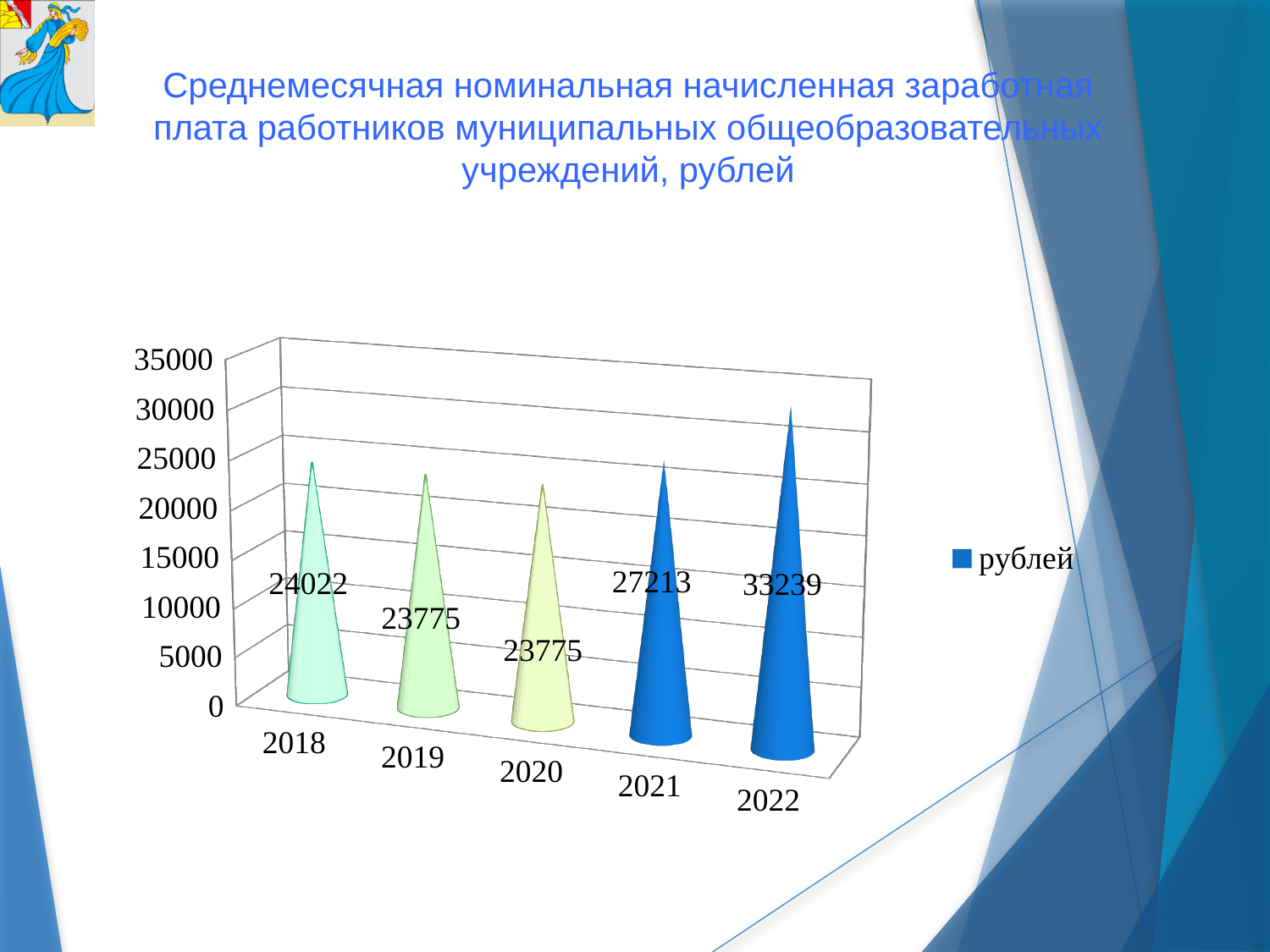
What is the difference between the values for 2022 and 2021? 6026 How many series does the legend list? 1 Which year has the highest value? 2022 What is the difference between the values for 2018 and 2019? 247 What is the value for 2022? 33239 What is the value for 2021? 27213 How many years are shown on the x axis? 5 What is the legend entry of the chart? рублей What is the value for 2019? 23775 What is the value for 2018? 24022 Which is larger, the value for 2018 or the value for 2021? 2021 Is the value for 2022 greater or less than 30000? greater